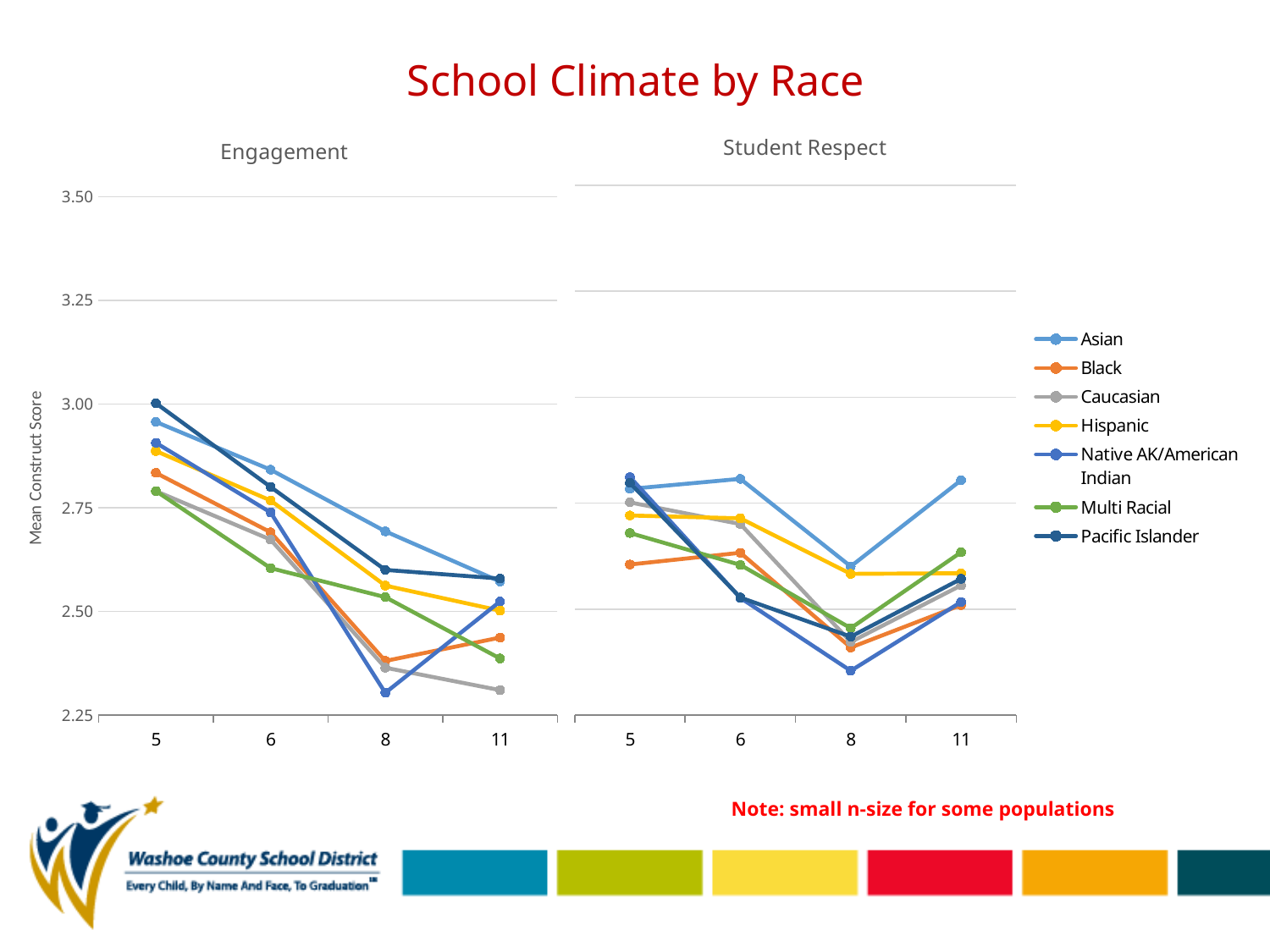
In the Engagement chart, is the value for Asian at grade 5 greater or less than 2.75? greater What kind of chart is the Engagement chart? line chart In the Engagement chart, which group has the lowest value at grade 8? Native AK/American Indian How many grade levels are plotted on the x axis of the Student Respect chart? 4 What is the label on the vertical axis of the charts? Mean Construct Score In the Student Respect chart, which group has the highest value at grade 11? Asian In the Student Respect chart, is the value for Asian at grade 11 greater or less than 2.75? greater In the Engagement chart, which is larger at grade 6: the value for Asian or the value for Multi Racial? Asian How many series does the legend list? 7 In the Engagement chart, what is the value for Pacific Islander at grade 5? 3.00 In the Engagement chart, is the value for Native AK/American Indian at grade 8 greater or less than 2.50? less In the Engagement chart, does the Asian line rise or fall from grade 5 to grade 11? fall